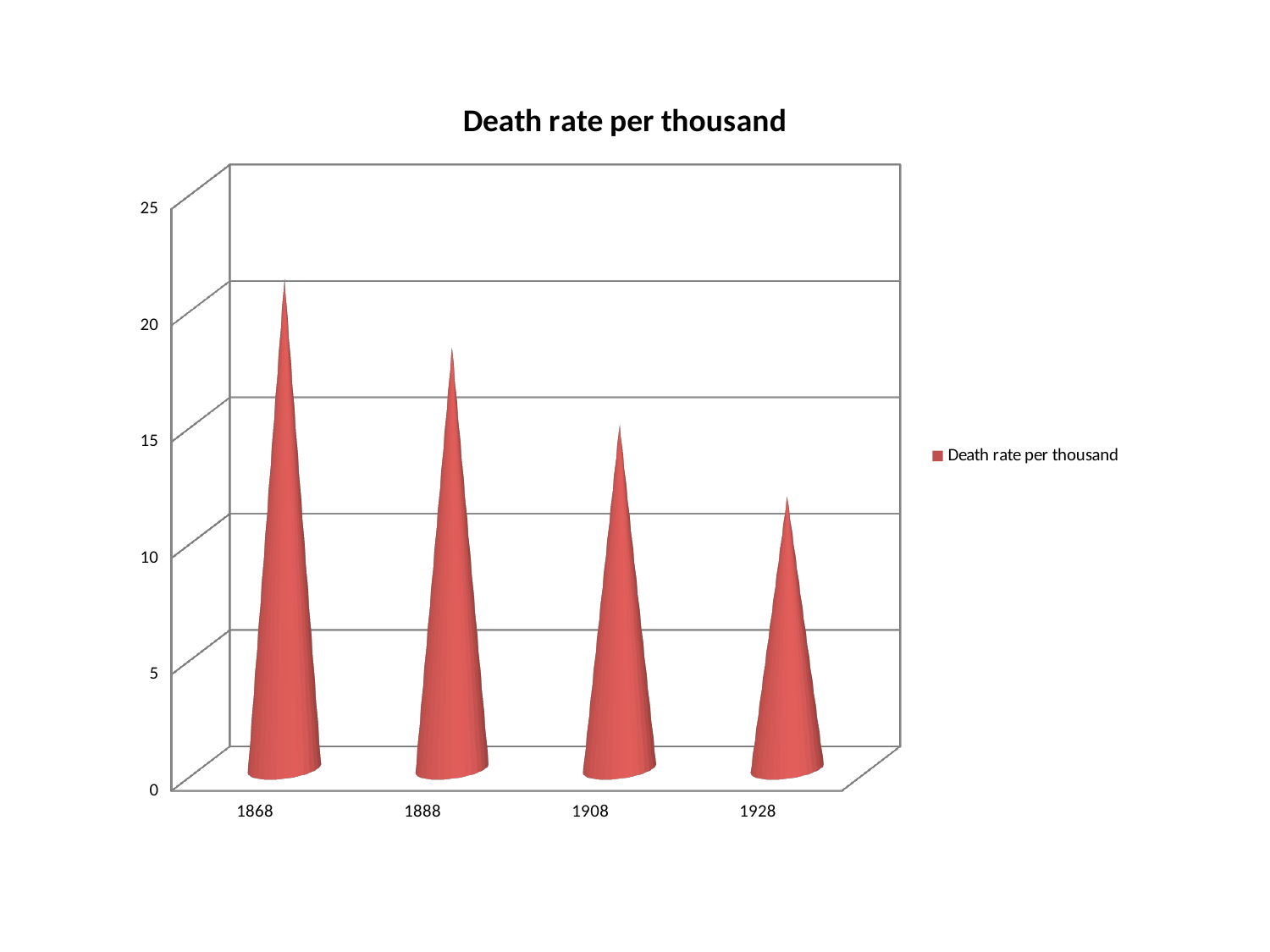
Which is larger, the death rate for 1868 or for 1928? 1868 Is the death rate for 1868 greater or less than 25? less Is the death rate for 1868 greater or less than 15? greater Is the death rate for 1908 greater or less than 10? greater How many years are shown on the x axis of the chart? 4 Which year has the lowest death rate per thousand? 1928 Which year has the highest death rate per thousand? 1868 What kind of chart is shown on the slide? bar chart Do the death rate values rise or fall from 1868 to 1928? fall How many series does the legend list? 1 What is the title of the chart? Death rate per thousand